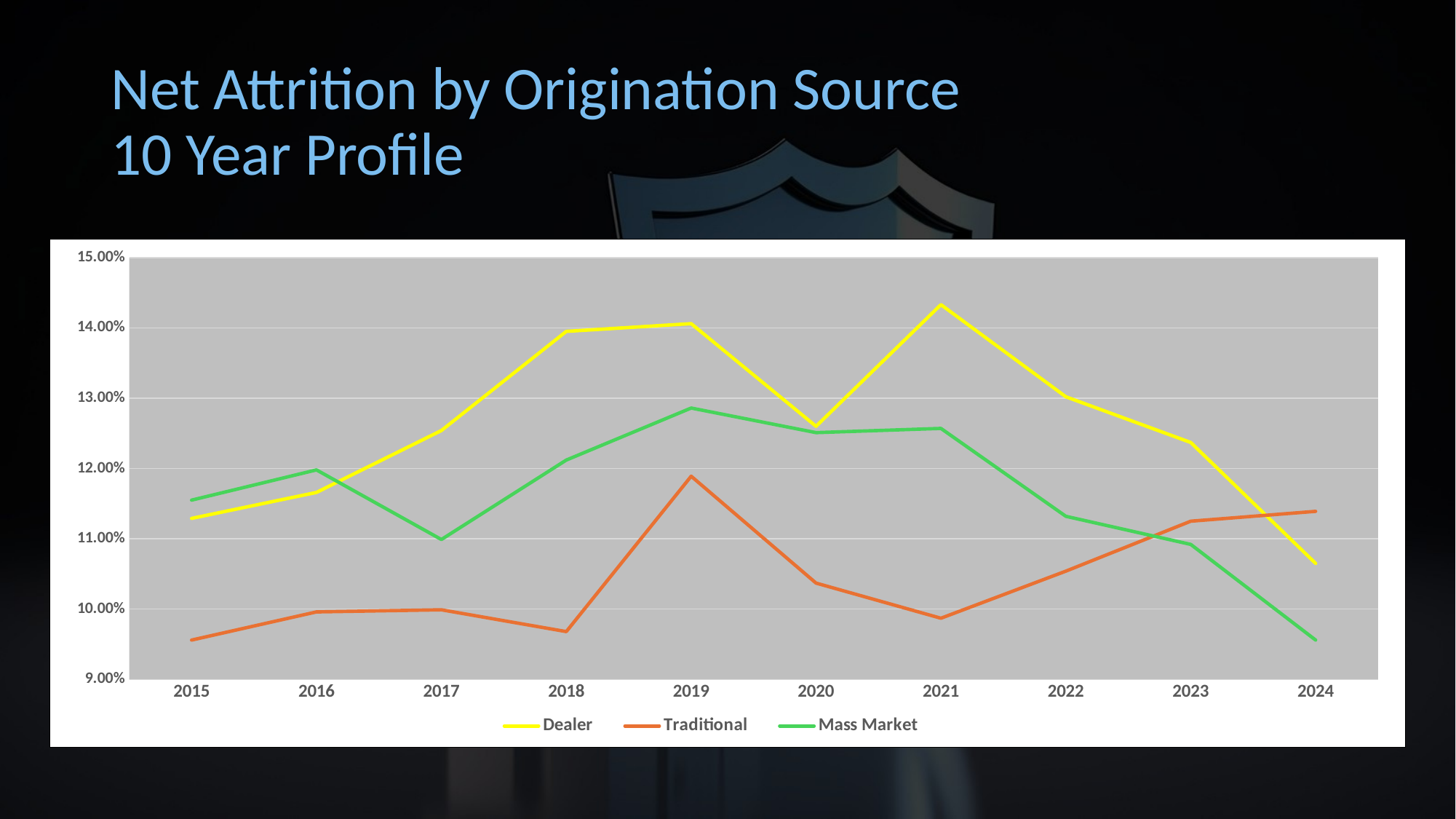
In 2024, which series has the higher value, Traditional or Mass Market? Traditional Is the value for Mass Market in 2019 greater or less than 12.00%? greater What kind of chart is shown on the slide? Line chart How many series does the legend list? 3 Is the value for Traditional in 2015 greater or less than 10.00%? less Is the value for Dealer in 2021 greater or less than 14.00%? greater In which year does the Dealer series reach its highest value? 2021 In which year does the Mass Market series reach its lowest value? 2024 Does the Mass Market series rise or fall from 2021 to 2024? Fall In 2019, which series has the higher value, Dealer or Traditional? Dealer How many years are plotted along the x axis? 10 What is the title of the slide? Net Attrition by Origination Source 10 Year Profile